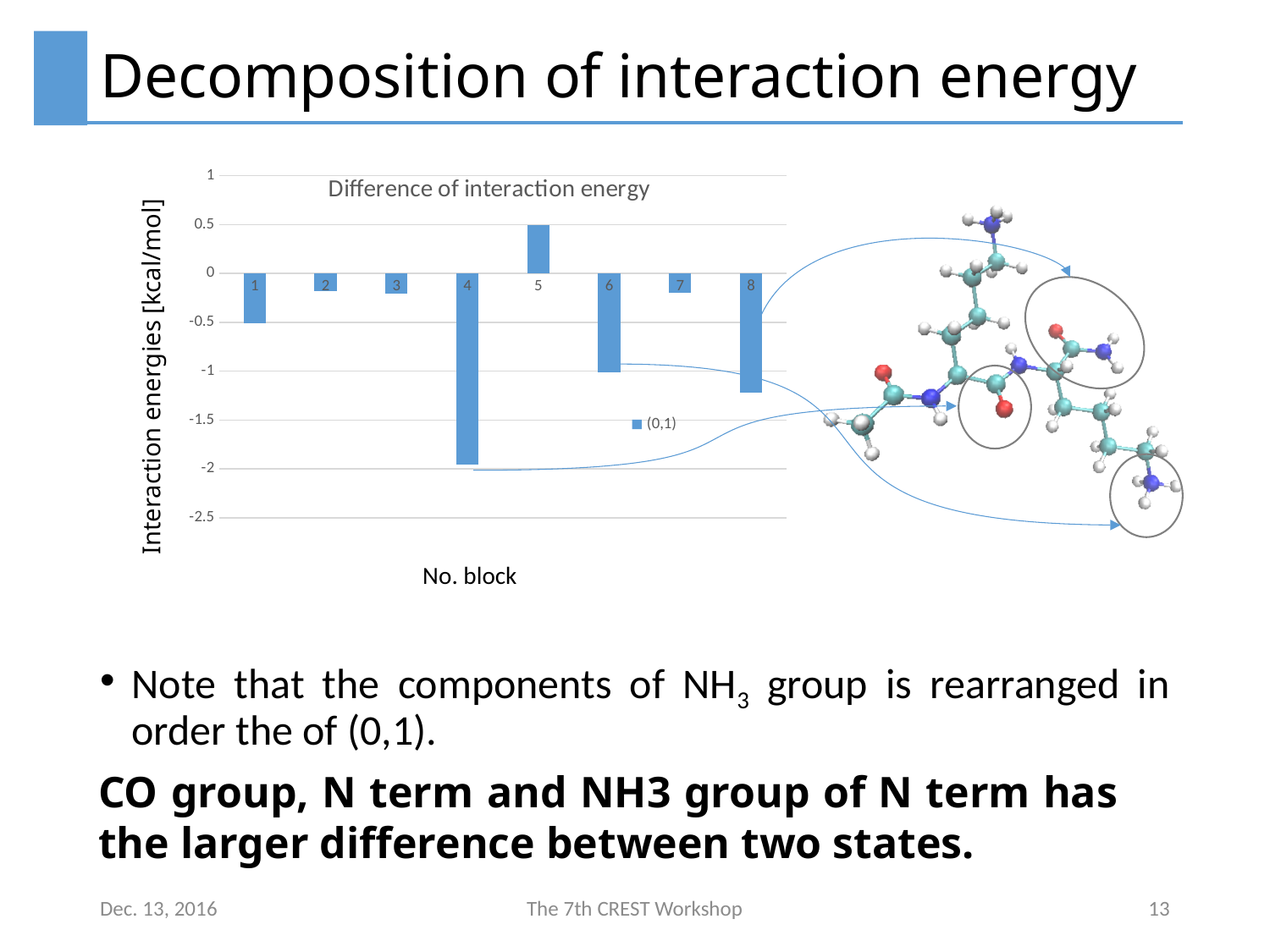
Is the value for block 6 greater or less than -0.5? less Is the value for block 8 greater or less than -1? less How many blocks are plotted on the x axis of the chart? 8 What kind of chart is shown on the slide? bar chart Which block has the lowest (most negative) interaction energy difference? 4 Is the value for block 4 greater or less than -1.5? less What is the title of the chart? Difference of interaction energy How many series does the chart legend list? 1 Which has the larger (more positive) value, block 4 or block 6? 6 Which block has the highest interaction energy difference? 5 What is the legend entry of the series in the chart? (0,1)